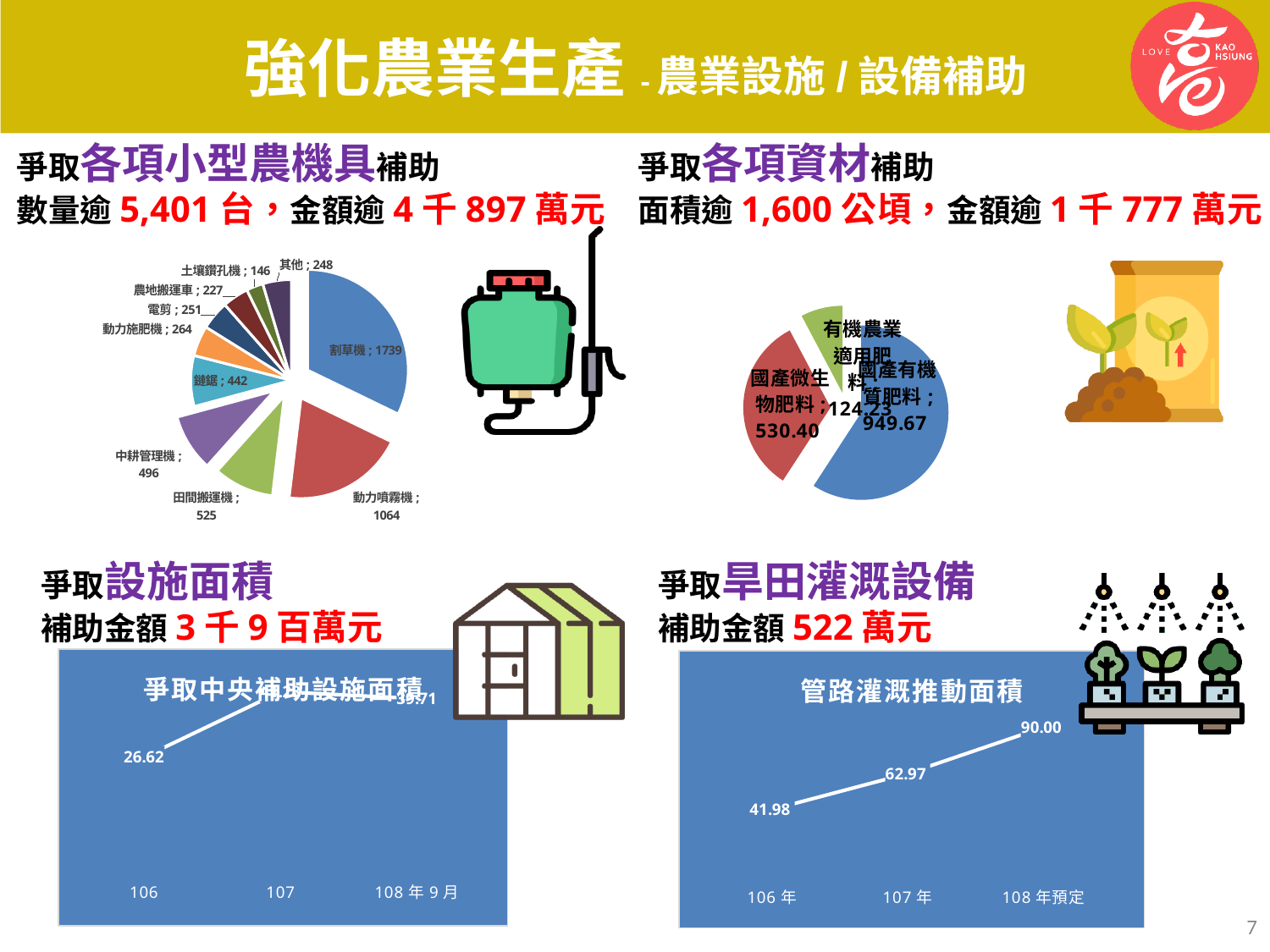
In the materials pie chart (right, top), which category has the largest value? 國產有機質肥料 In the materials pie chart (right, top), what is the difference between 國產微生物肥料 and 有機農業適用肥料? 406.17 In the pie chart of small farm machinery (left, top), which category has the smallest value? 土壤鑽孔機 In the pie chart of small farm machinery (left, top), which is larger, 田間搬運機 or 中耕管理機? 田間搬運機 In the pie chart of small farm machinery (left, top), what is the value for 動力噴霧機? 1064 In the materials pie chart (right, top), what is the value for 國產有機質肥料? 949.67 In the chart titled 管路灌溉推動面積 (bottom right), what is the value for 107 年? 62.97 In the chart titled 爭取中央補助設施面積 (bottom left), what is the value for 106? 26.62 In the pie chart of small farm machinery (left, top), how many categories are shown? 10 In the pie chart of small farm machinery (left, top), what is the difference between 割草機 and 動力噴霧機? 675 In the chart titled 管路灌溉推動面積 (bottom right), do the values rise or fall from 106 年 to 108 年預定? rise In the pie chart of small farm machinery (left, top), what is the value for 割草機? 1739